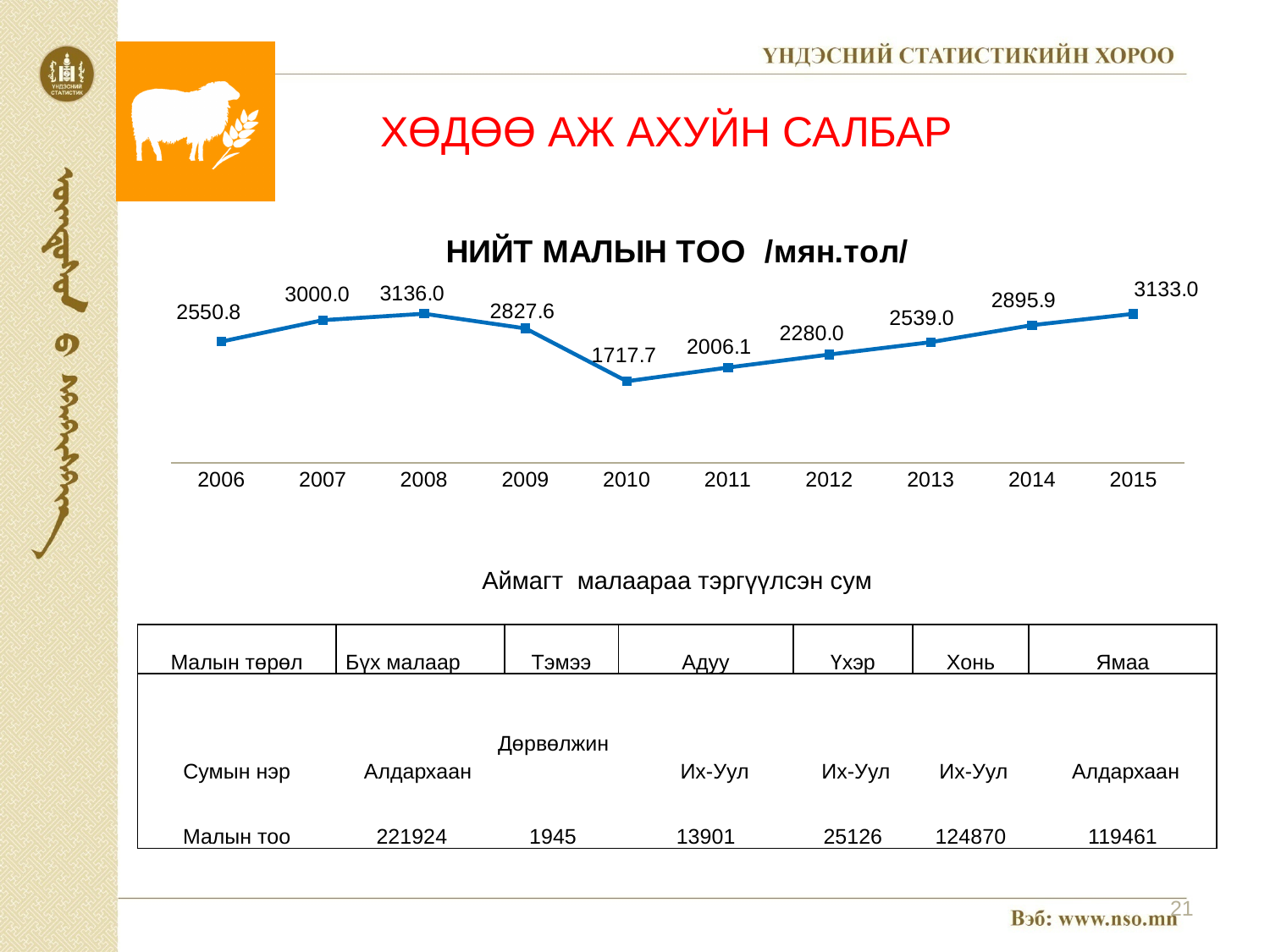
What is the value for 2006? 2550.8 What type of chart is shown on the slide? line chart Do the values rise or fall from 2010 to 2015? rise What is the difference between the values for 2009 and 2010? 1109.9 Which year has the lowest value? 2010 What is the title of the chart? НИЙТ МАЛЫН ТОО /мян.тол/ What is the difference between the values for 2015 and 2014? 237.1 What is the value for 2010? 1717.7 Which year has the highest value? 2008 How many years are plotted on the x axis? 10 Which is larger, the value for 2007 or the value for 2014? 2007 What is the value for 2015? 3133.0